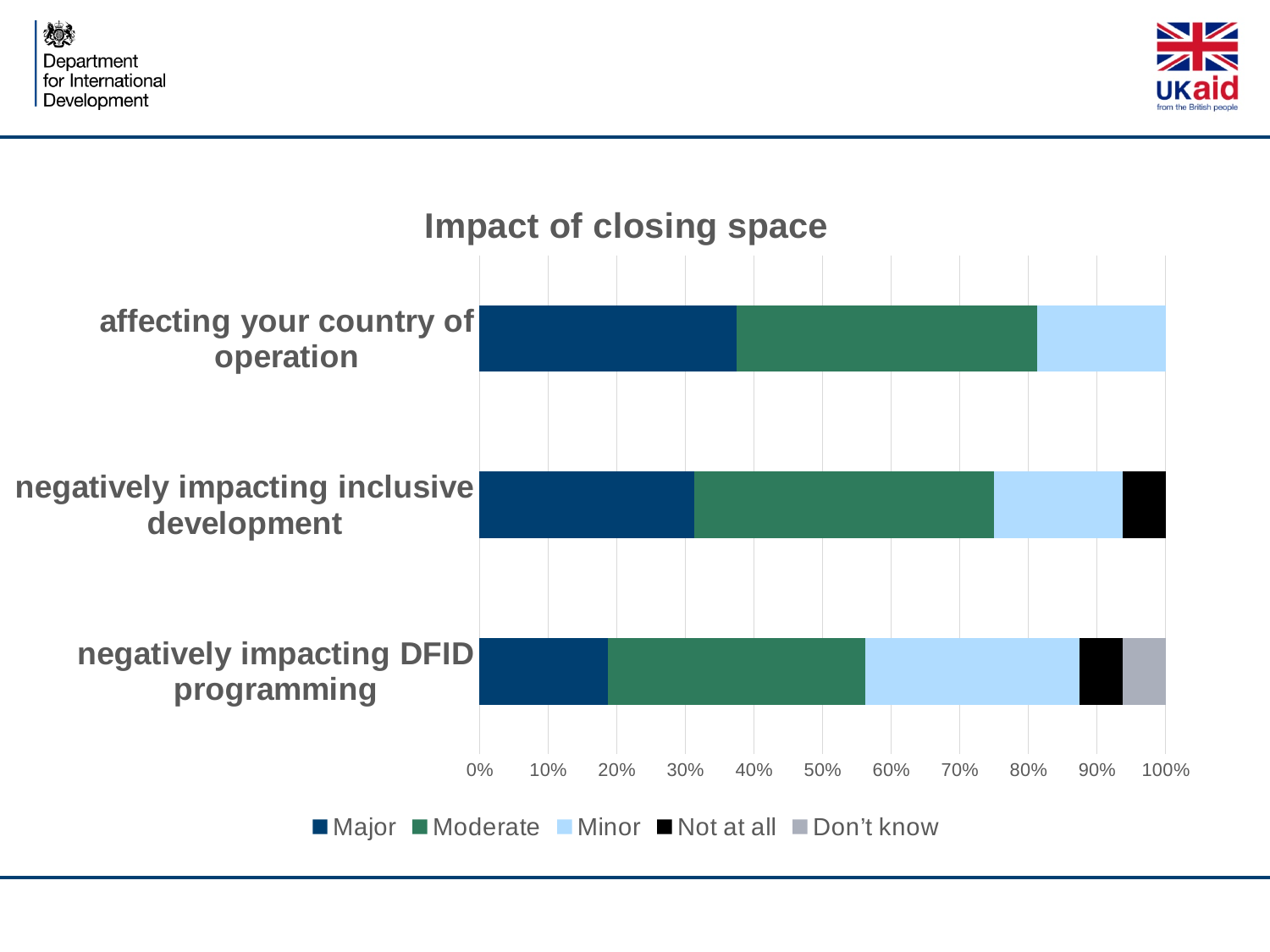
Which category has the smallest Major segment? negatively impacting DFID programming Which category is the only one with a 'Don't know' segment? negatively impacting DFID programming Is the Major value for 'negatively impacting inclusive development' greater or less than 20%? greater Which category has the largest Major segment? affecting your country of operation Which category has the largest Minor segment? negatively impacting DFID programming Is the Major value for 'affecting your country of operation' greater or less than 30%? greater What kind of chart is shown on the slide? bar chart What is the title of the chart? Impact of closing space Which is larger: the Major segment for 'affecting your country of operation' or for 'negatively impacting DFID programming'? affecting your country of operation Is the Major value for 'negatively impacting DFID programming' greater or less than 30%? less How many series does the legend list? 5 How many categories are plotted on the chart? 3